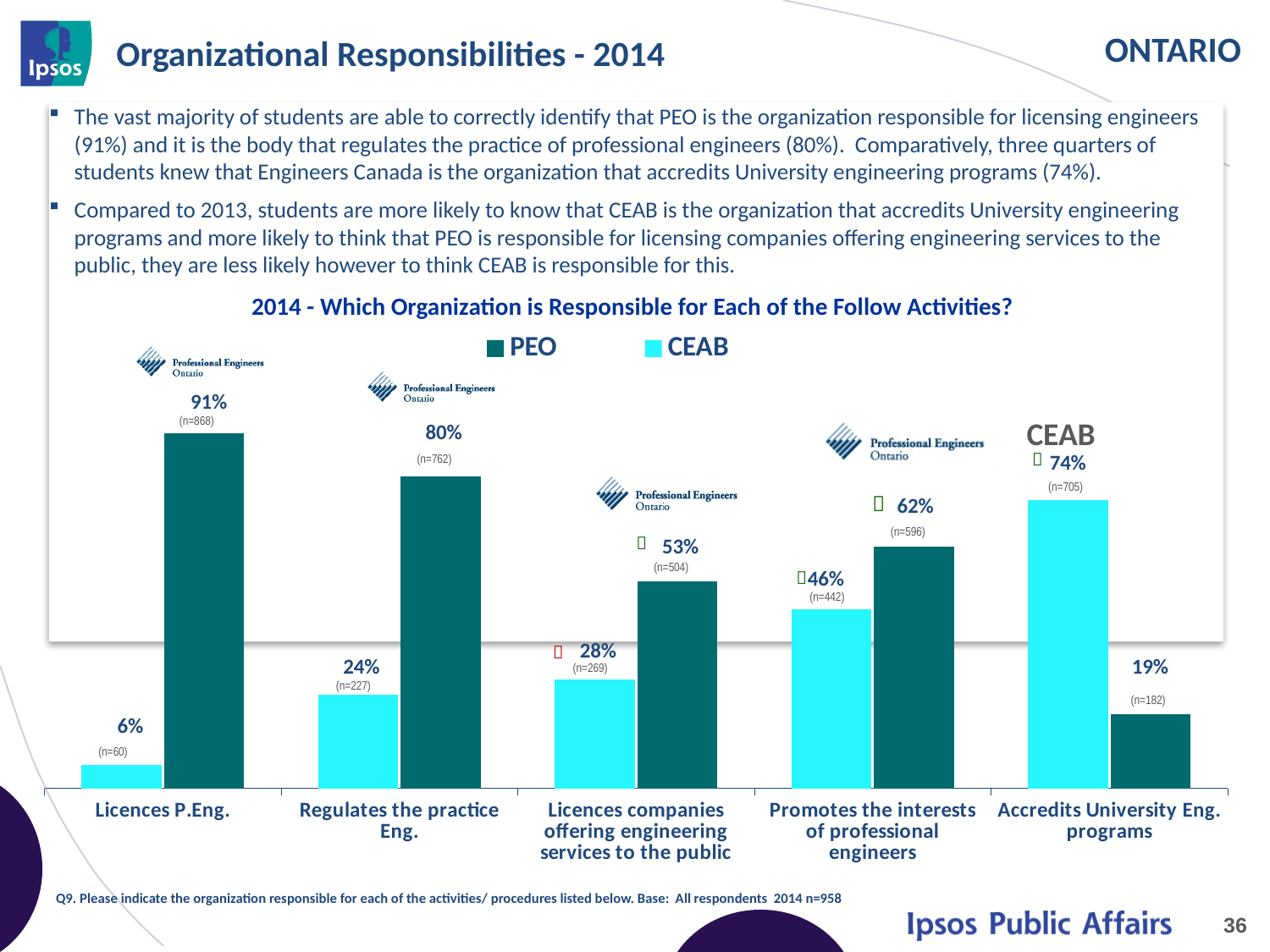
What is the title of the chart? 2014 - Which Organization is Responsible for Each of the Follow Activities? What is the PEO value for 'Promotes the interests of professional engineers'? 62% How many series does the chart legend list? 2 What is the CEAB value for 'Licences companies offering engineering services to the public'? 28% What type of chart is used on this slide? Bar chart For which activity is the CEAB value the highest? Accredits University Eng. programs What is the difference between the PEO and CEAB values for 'Regulates the practice Eng.'? 56 percentage points What percentage of students said PEO is responsible for licensing P.Eng.? 91% For which activity is the PEO value the lowest? Accredits University Eng. programs How many activities are shown on the x axis of the chart? 5 Which is larger for 'Promotes the interests of professional engineers': the PEO value or the CEAB value? PEO What percentage of students said CEAB accredits University Eng. programs? 74%